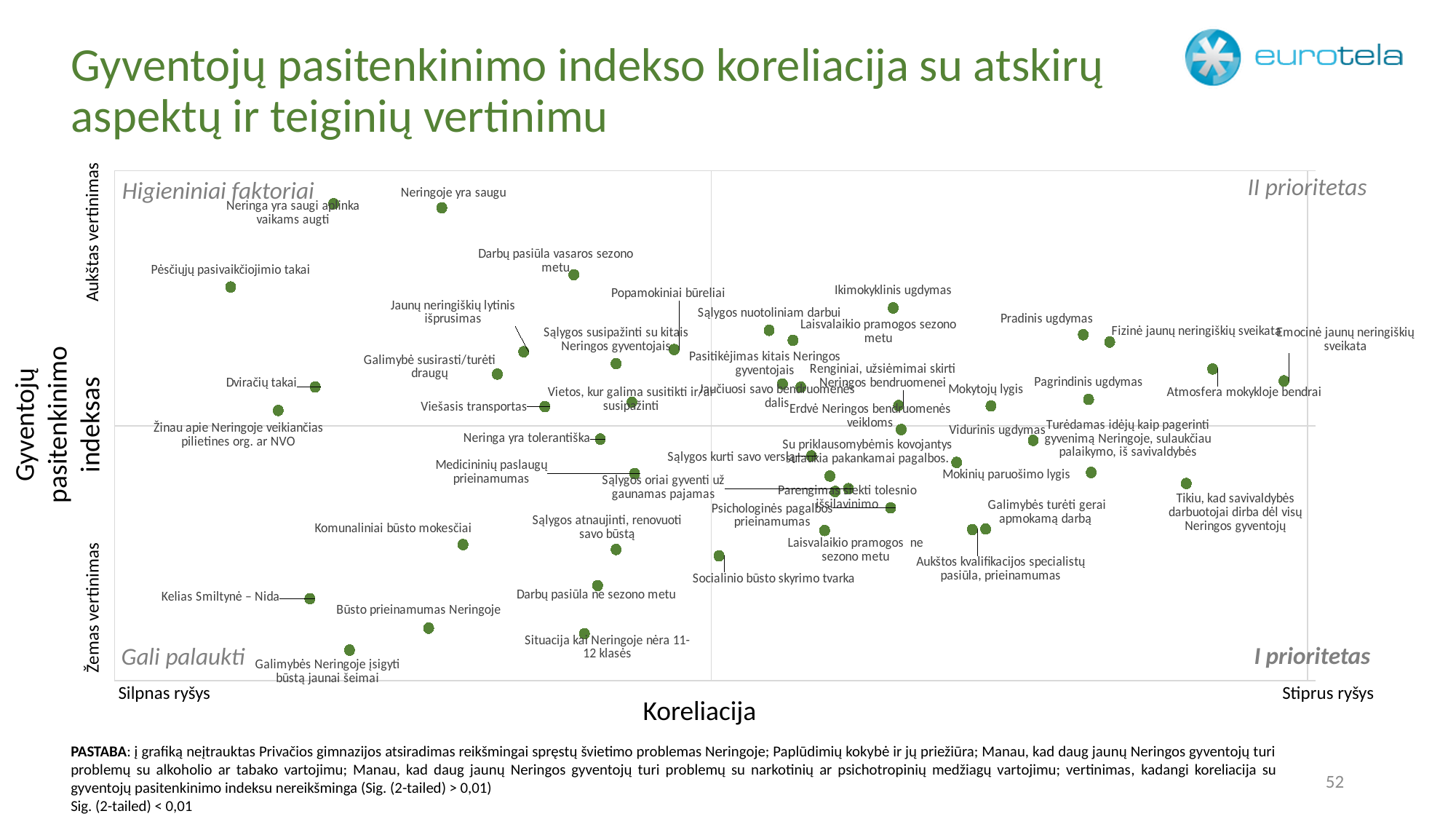
Which point is plotted further to the right: 'Pradinis ugdymas' or 'Dviračių takai'? Pradinis ugdymas In which labelled quadrant of the chart does the point 'Pradinis ugdymas' fall? II prioritetas In which labelled quadrant of the chart does the point 'Aukštos kvalifikacijos specialistų pasiūla, prieinamumas' fall? I prioritetas What is the label of the horizontal axis of the chart? Koreliacija In which labelled quadrant of the chart does the point 'Neringoje yra saugu' fall? Higieniniai faktoriai Which point is plotted furthest to the right (strongest correlation) on the chart? Emocinė jaunų neringiškių sveikata In which labelled quadrant of the chart does the point 'Kelias Smiltynė – Nida' fall? Gali palaukti Which point is plotted furthest to the left (weakest correlation) on the chart? Pėsčiųjų pasivaikščiojimo takai What kind of chart is shown on the slide? Scatter plot Which point is plotted lowest on the vertical axis (lowest satisfaction rating) on the chart? Galimybės Neringoje įsigyti būstą jaunai šeimai What label is printed in the top-right quadrant of the chart? II prioritetas Which point is plotted higher on the vertical axis: 'Neringoje yra saugu' or 'Kelias Smiltynė – Nida'? Neringoje yra saugu